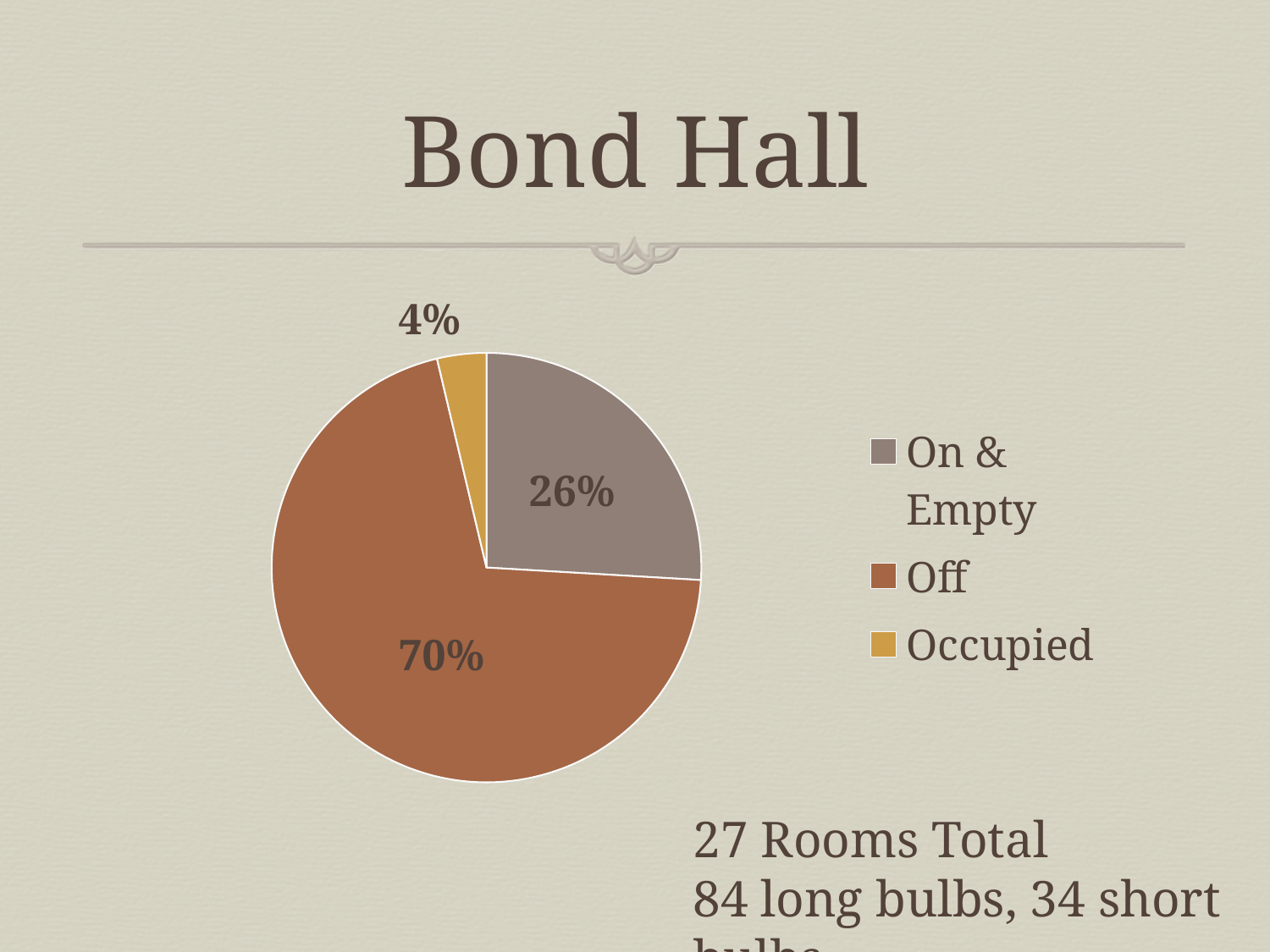
How many categories does the pie chart show? 3 What share of the pie is labelled "On & Empty"? 26% What share of the pie is labelled "Occupied"? 4% Which category has the smallest slice of the pie? Occupied Which category has the largest slice of the pie? Off What kind of chart is shown on the slide? Pie chart Which slice is larger, "On & Empty" or "Occupied"? On & Empty What is the title of the slide containing the pie chart? Bond Hall What is the difference in percentage points between the "On & Empty" slice and the "Occupied" slice? 22 What is the difference in percentage points between the "Off" slice and the "On & Empty" slice? 44 What share of the pie is labelled "Off"? 70% What colour is the "Occupied" slice in the pie chart? Gold